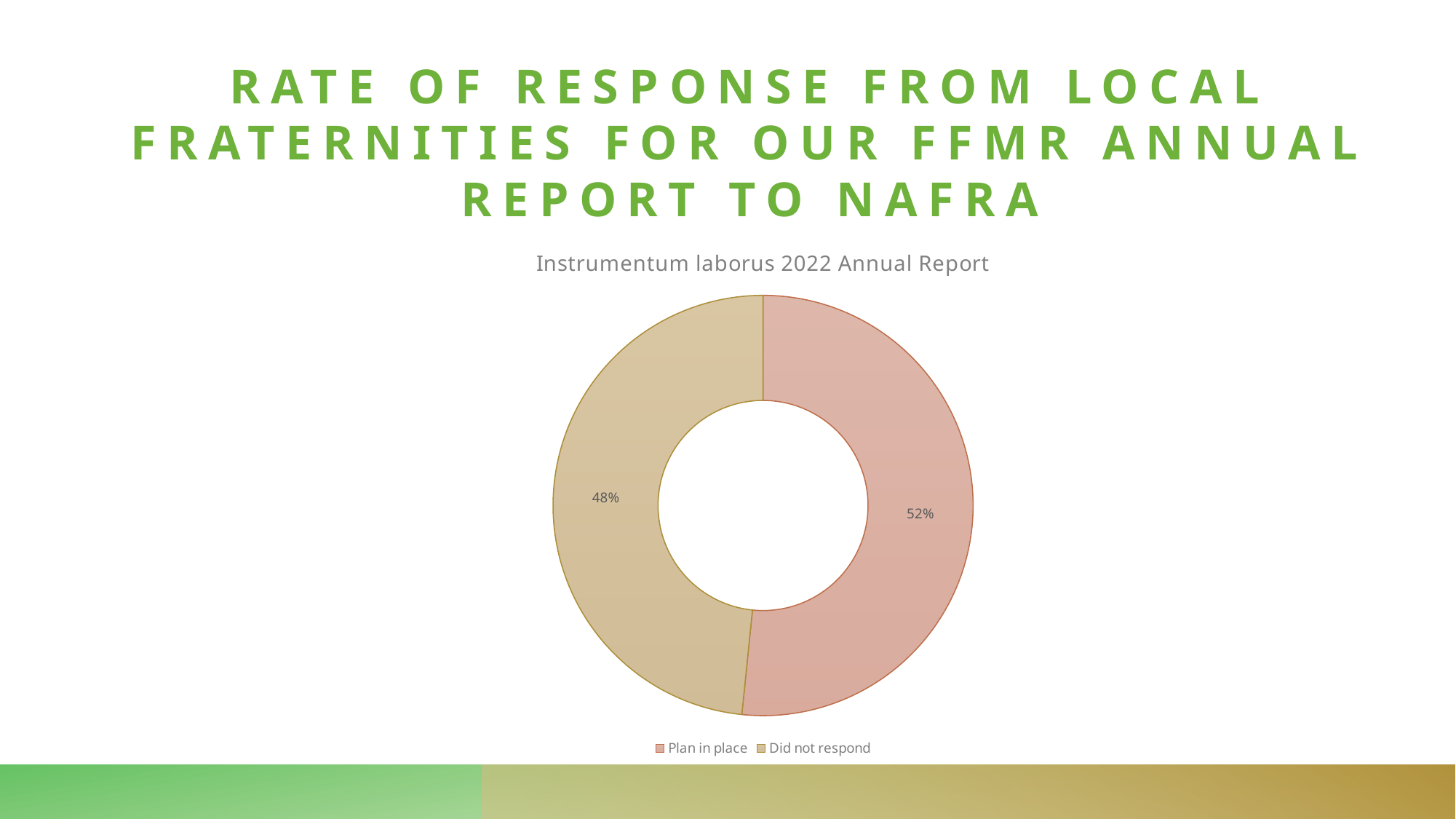
What is the difference in percentage points between "Plan in place" and "Did not respond"? 4 What share of the chart does "Plan in place" represent? 52% What is the title of the chart? Instrumentum laborus 2022 Annual Report What kind of chart is shown on the slide? Doughnut (pie) chart Is the share for "Plan in place" greater or less than 50%? greater What share of the chart does "Did not respond" represent? 48% Which category has the largest share? Plan in place Which category is shown in the pink/red colour? Plan in place Which is larger, the share for "Plan in place" or for "Did not respond"? Plan in place How many categories are shown in the chart? 2 Which category has the smallest share? Did not respond